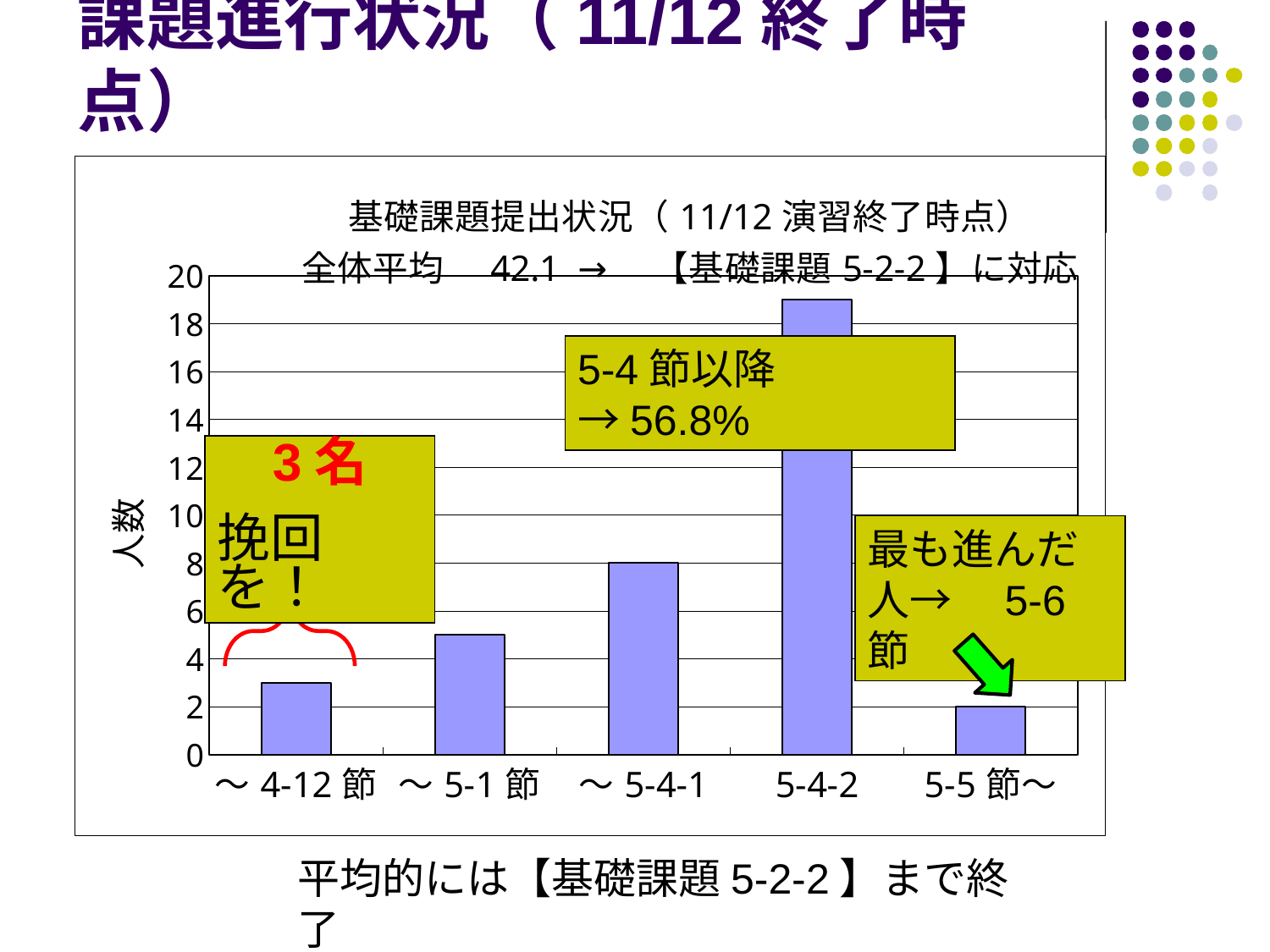
What is the value (人数) for ～4-12節? 3 What is the value (人数) for 5-5節～? 2 How many categories are shown on the x axis of the chart? 5 What is the value (人数) for ～5-4-1? 8 Is the value for 5-4-2 greater or less than 18? greater Which category has the lowest bar? 5-5節～ Which is larger, the value for ～5-4-1 or the value for ～5-1節? ～5-4-1 What is the difference between the values for ～5-4-1 and 5-5節～? 6 What is the title of the chart? 基礎課題提出状況（11/12演習終了時点） 全体平均 42.1 → 【基礎課題5-2-2】に対応 What type of chart is shown on the slide? bar chart Which category has the highest bar? 5-4-2 Is the value for ～5-1節 greater or less than 6? less